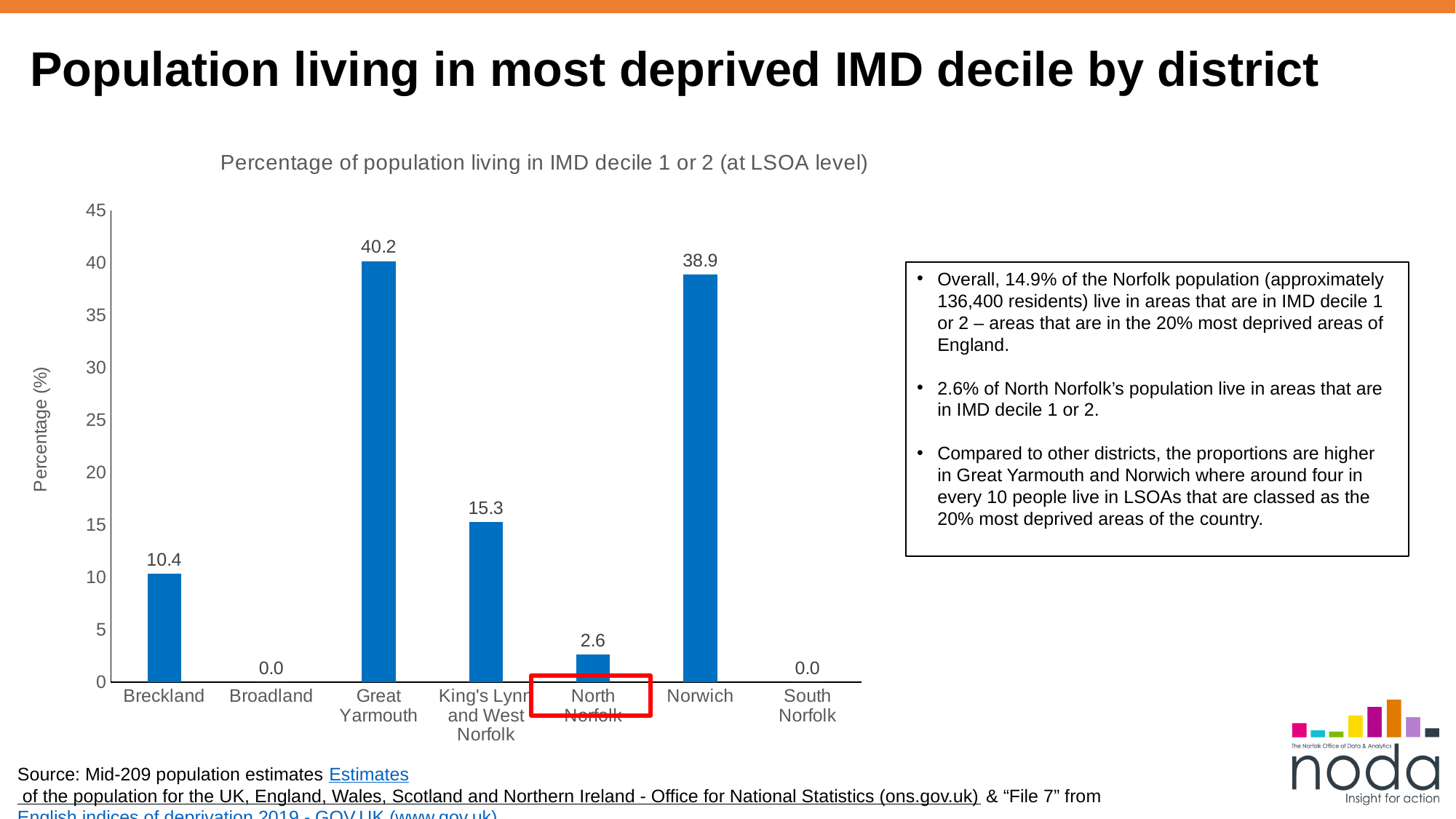
How many districts are shown on the x axis? 7 What is the label of the y axis? Percentage (%) How many districts have a value of 0.0? 2 Which district has the highest percentage? Great Yarmouth What is the value for North Norfolk? 2.6 What is the title of the chart? Percentage of population living in IMD decile 1 or 2 (at LSOA level) What is the value for King's Lynn and West Norfolk? 15.3 What kind of chart is this? Bar chart What is the difference between the values for Great Yarmouth and Norwich? 1.3 What is the value for Great Yarmouth? 40.2 What is the difference between the values for Breckland and North Norfolk? 7.8 Which is larger, the value for Breckland or the value for King's Lynn and West Norfolk? King's Lynn and West Norfolk